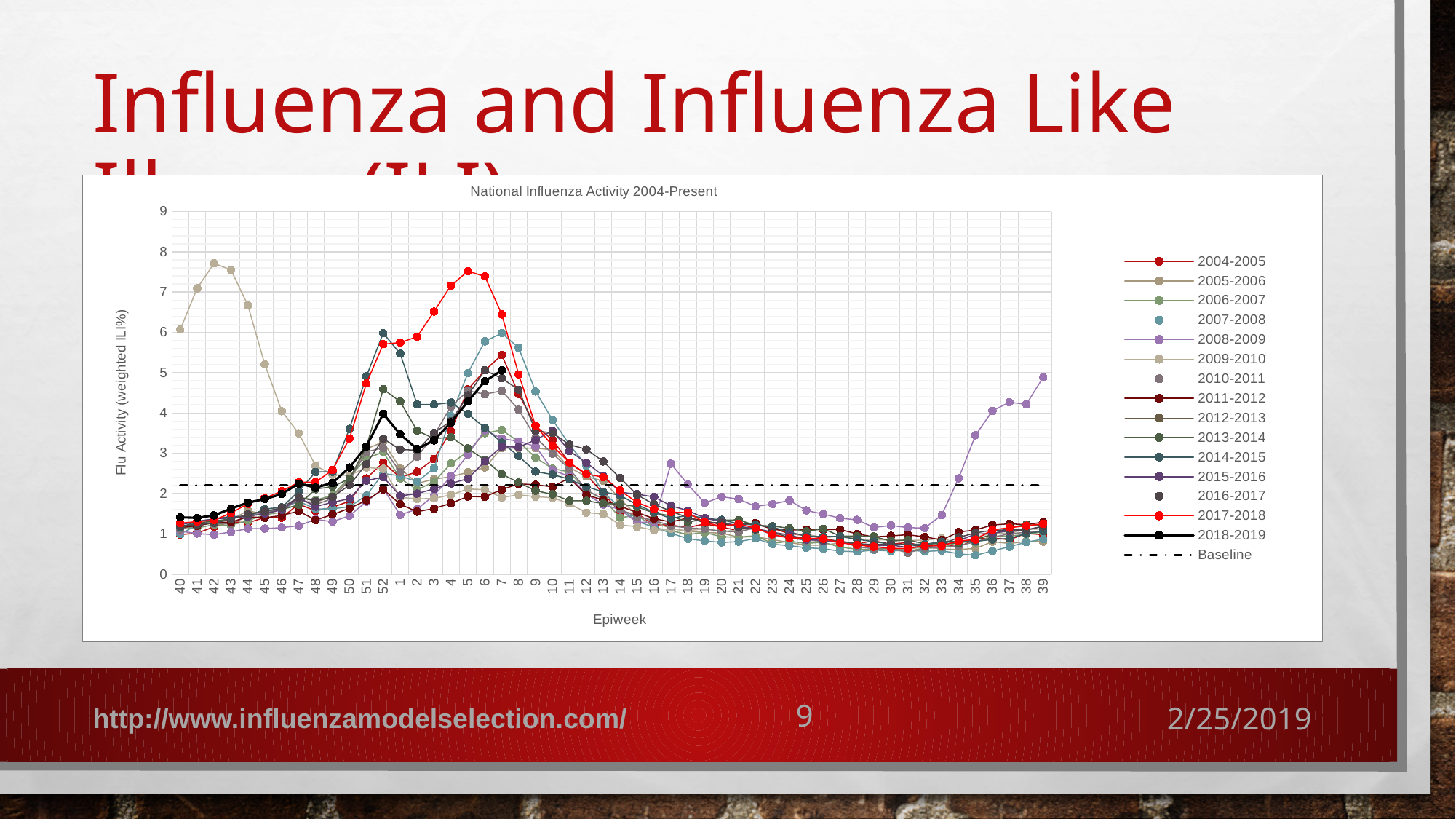
What is the label of the y axis? Flu Activity (weighted ILI%) Is the value for 2007-2008 at epiweek 7 greater or less than 5? greater How many epiweek categories are shown along the x axis? 52 Does the 2008-2009 line rise or fall between epiweek 33 and epiweek 39? rise Is the value for 2005-2006 at epiweek 42 greater or less than 7? less How many entries does the chart legend list? 16 Is the value for 2017-2018 at epiweek 5 greater or less than 7? greater Which of the two is larger at epiweek 5: the value for 2017-2018 or the value for 2018-2019? 2017-2018 What kind of chart is shown on the slide? line chart What is the title of the chart? National Influenza Activity 2004-Present